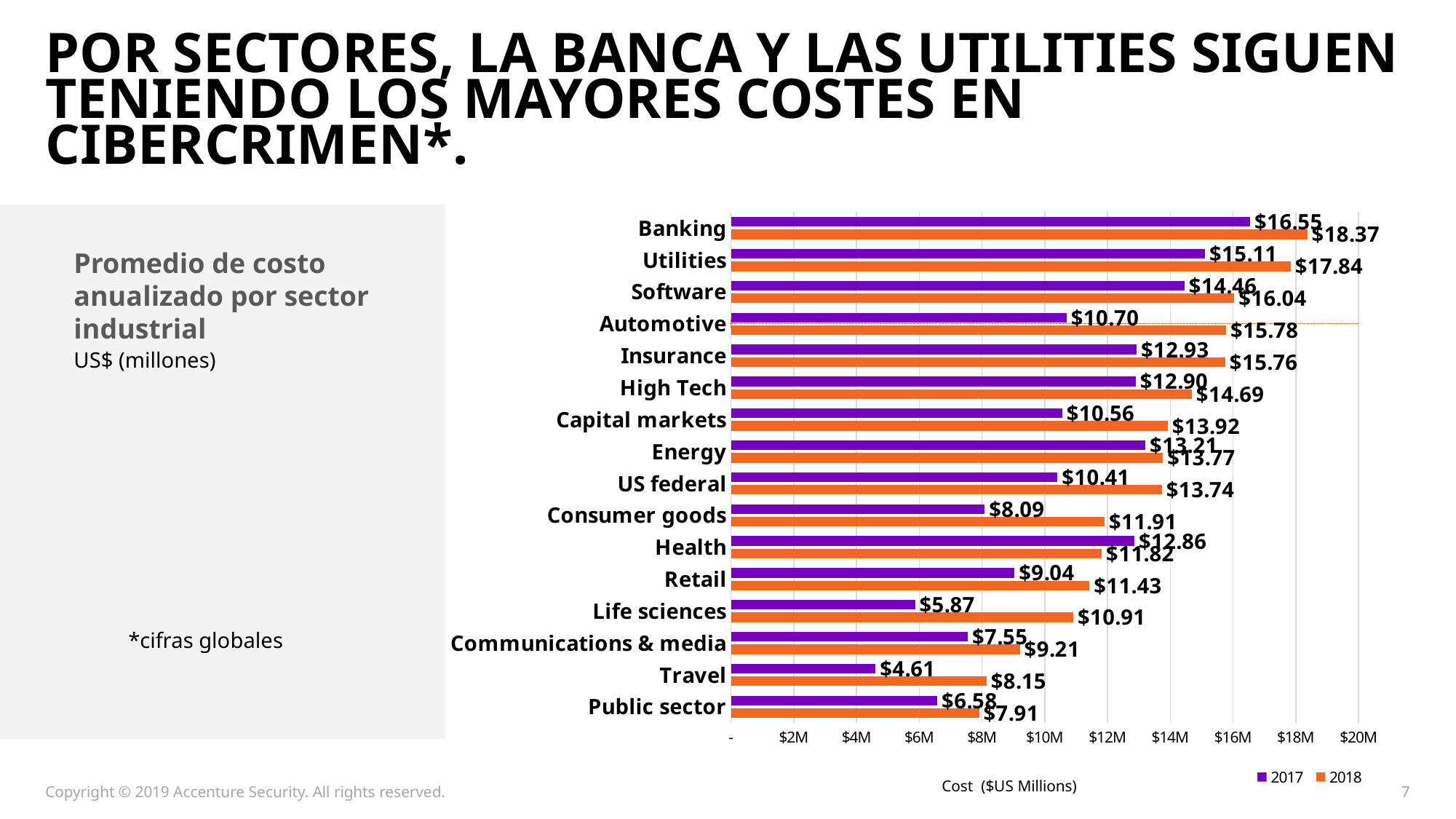
What is the 2017 value for Life sciences? $5.87 For Health, which is larger, the 2017 value or the 2018 value? 2017 Which sector has the lowest 2017 value? Travel Which sector has the highest 2018 value? Banking How many series does the legend list? 2 What is the difference between the 2018 and 2017 values for Banking? $1.82 What is the 2018 value for Banking? $18.37 What is the 2018 value for Automotive? $15.78 What kind of chart is shown on the slide? Bar chart Which is larger, the 2018 value for Utilities or the 2018 value for Software? Utilities How many sectors are shown on the chart? 16 What is the difference between the 2018 and 2017 values for Automotive? $5.08